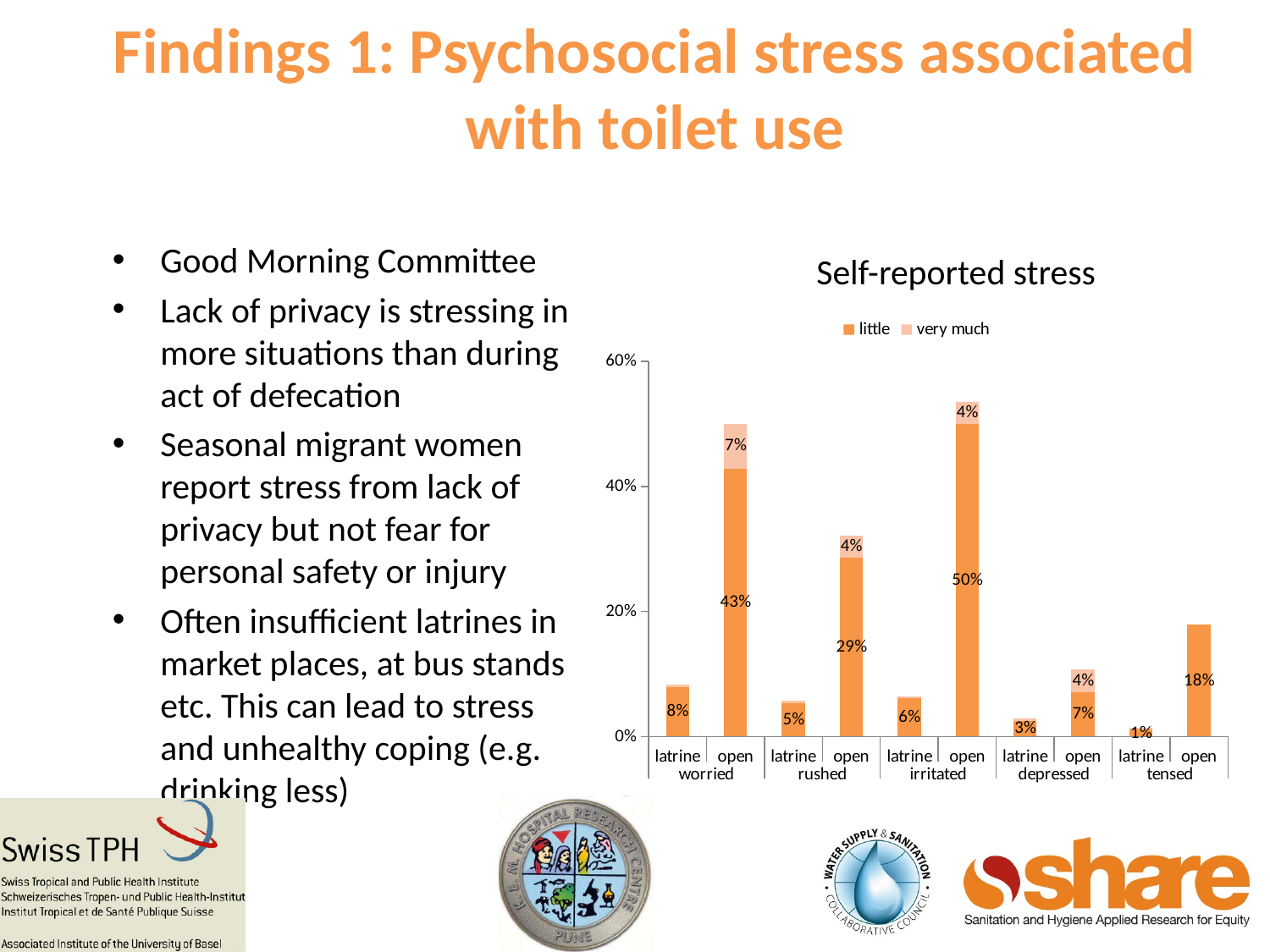
What is the difference between the 'little' values for open defecation in the irritated and worried categories? 7% Is the total height of the open bar in the worried category greater or less than 40%? greater What is the 'little' value for open defecation in the worried category? 43% How many stress categories (worried, rushed, etc.) are shown along the x axis? 5 How many series does the legend of the Self-reported stress chart list? 2 Which of the two is larger: the 'little' value for open in the rushed category or the 'little' value for open in the tensed category? open, rushed Which bar is the tallest in the Self-reported stress chart? open, irritated What is the total of the stacked bar for open defecation in the rushed category? 33% What is the 'little' value for latrine in the depressed category? 3% What is the total of the stacked bar for open defecation in the worried category? 50% What is the 'very much' value for open defecation in the irritated category? 4% What kind of chart is shown on the slide? bar chart